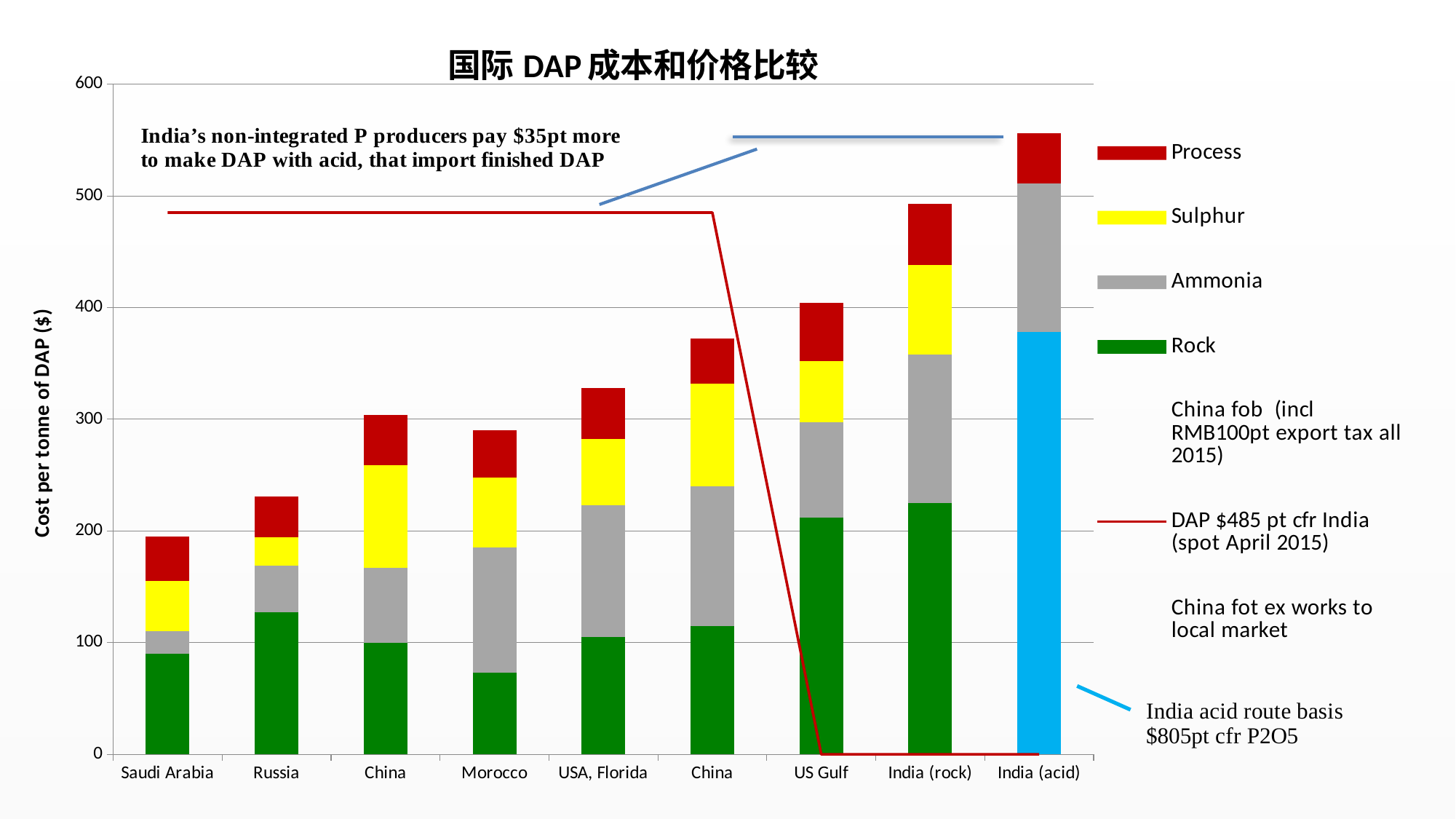
Is the total bar for India (acid) greater or less than 500? greater Is the total bar for Morocco greater or less than 300? less Which category has the shortest total bar? Saudi Arabia Is the total bar for USA, Florida greater or less than 300? greater What is the label of the y axis? Cost per tonne of DAP ($) How many countries/categories are shown on the x axis? 9 How many stacked bar components (entries with coloured boxes) does the legend list? 4 Which has the larger total bar, US Gulf or India (rock)? India (rock) Which category has the tallest total bar? India (acid) Which has the larger total bar, Russia or Morocco? Morocco Do the total bar heights generally rise or fall from left to right across the x axis? rise What kind of chart is shown on the slide? Combination stacked bar and line chart